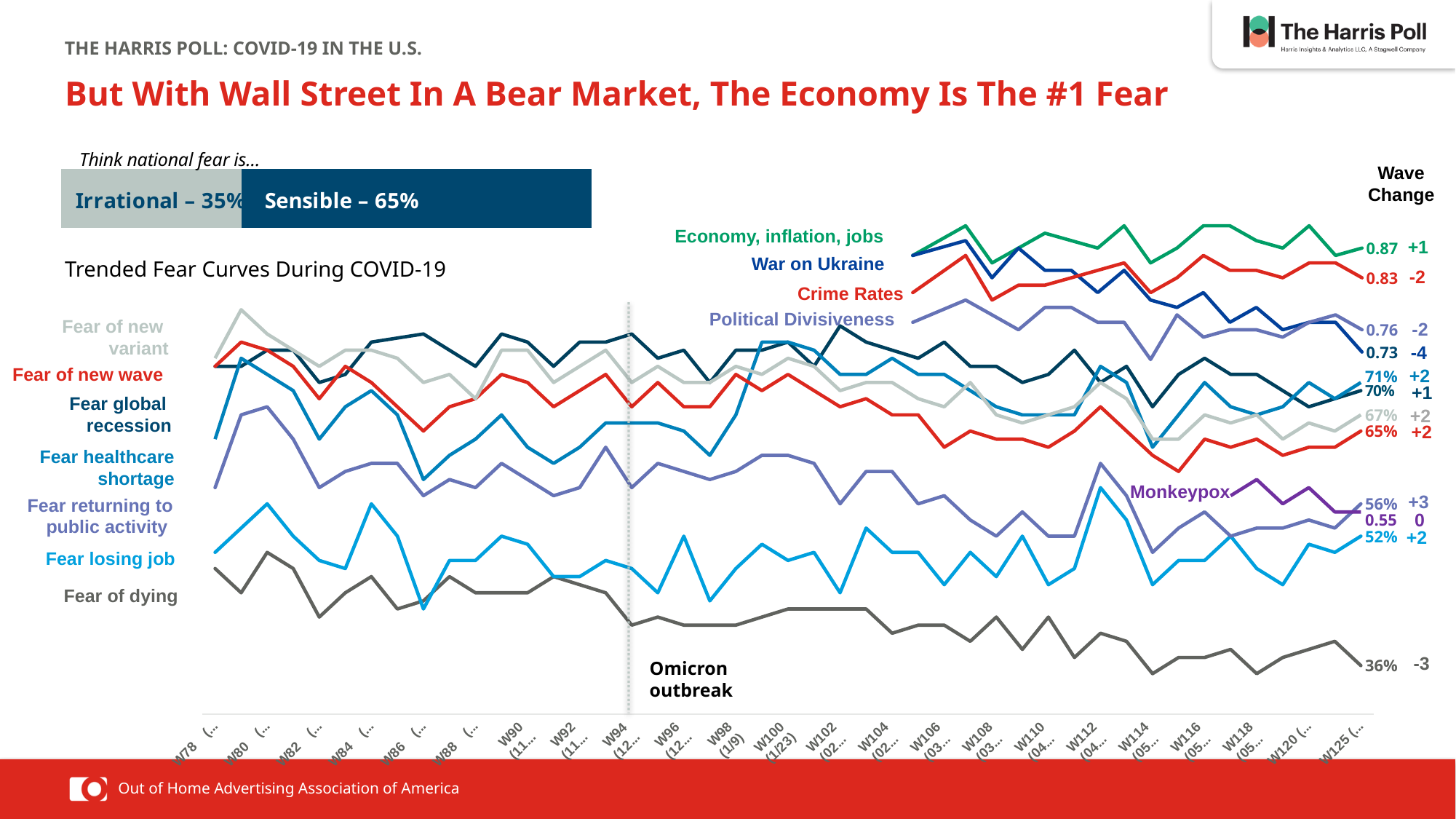
In the Trended Fear Curves chart, what is the wave change shown for 'Monkeypox'? 0 In the Trended Fear Curves chart, what is the latest value shown for 'Economy, inflation, jobs'? 0.87 In the Trended Fear Curves chart, what is the wave change shown for 'War on Ukraine'? -4 In the Trended Fear Curves chart, which fear has the lowest latest value? Fear of dying In the 'Think national fear is...' bar, what percentage say national fear is Irrational? 35% In the Trended Fear Curves chart, which has a higher latest value: 'Fear of new variant' or 'Fear of new wave'? Fear of new variant What type of chart is the Trended Fear Curves During COVID-19 chart? Line chart In the 'Think national fear is...' bar, what is the total of the Irrational and Sensible segments? 100% In the Trended Fear Curves chart, which fear has the highest latest value? Economy, inflation, jobs In the 'Think national fear is...' bar, what percentage say national fear is Sensible? 65% In the Trended Fear Curves chart, what is the latest value shown for 'Fear of dying'? 36% In the Trended Fear Curves chart, what is the difference between the latest values for 'Fear losing job' (52%) and 'Fear of dying' (36%)? 16%